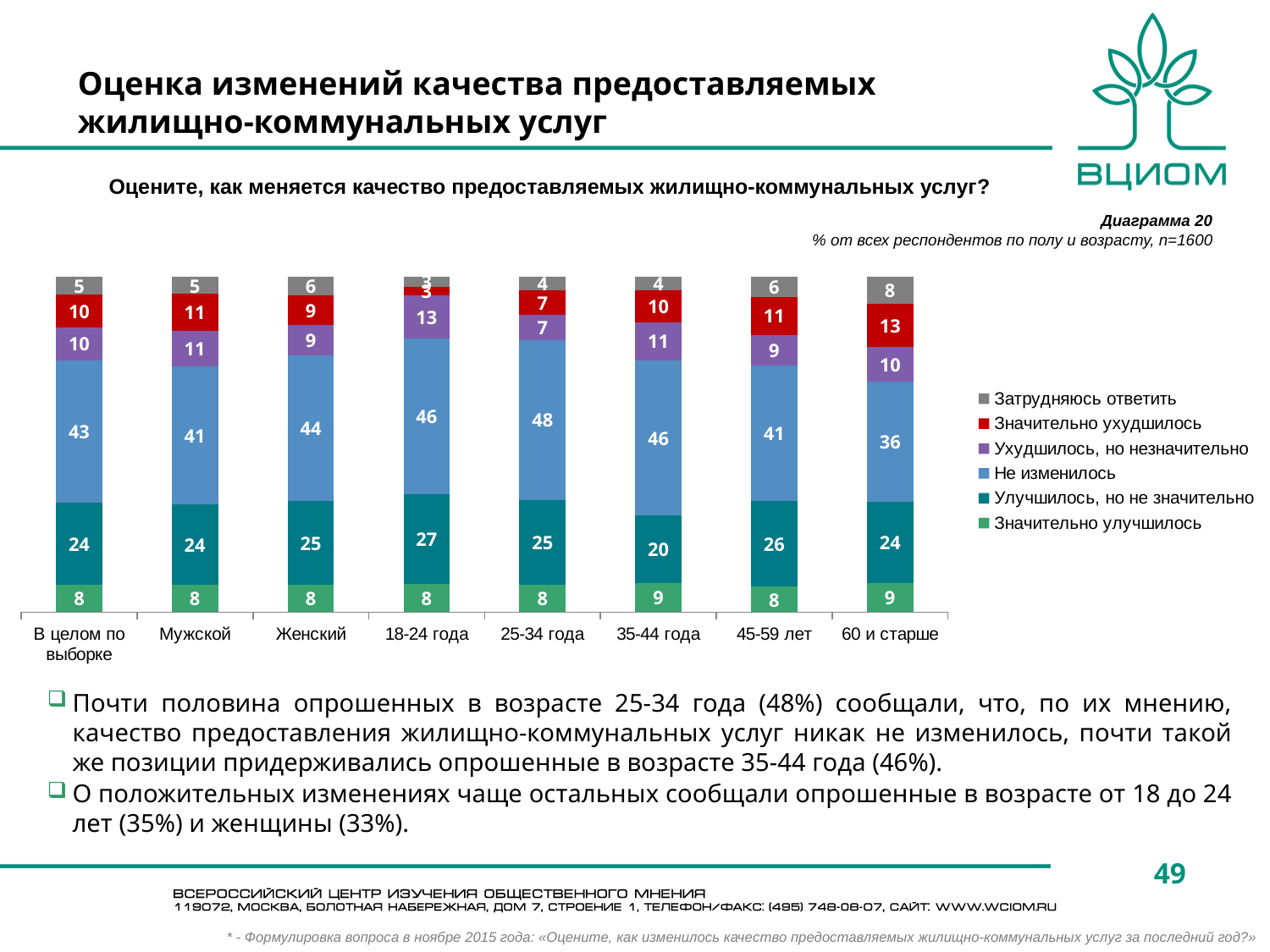
How many series does the chart legend list? 6 What is the value of "Улучшилось, но не значительно" for the "18-24 года" category? 27 What is the value of "Не изменилось" for the "25-34 года" category? 48 Which series is shown in red in the chart? Значительно ухудшилось Which is larger: the "Улучшилось, но не значительно" value for "Женский" or for "35-44 года"? Женский What is the difference between the "Не изменилось" values for "25-34 года" and "60 и старше"? 12 Which category has the lowest value for "Не изменилось"? 60 и старше What is the total of the stacked bar for "В целом по выборке"? 100 What type of chart is shown on the slide? Stacked bar chart How many categories are shown along the x axis of the chart? 8 What is the value of "Значительно ухудшилось" for the "60 и старше" category? 13 Which category has the highest value for "Не изменилось"? 25-34 года